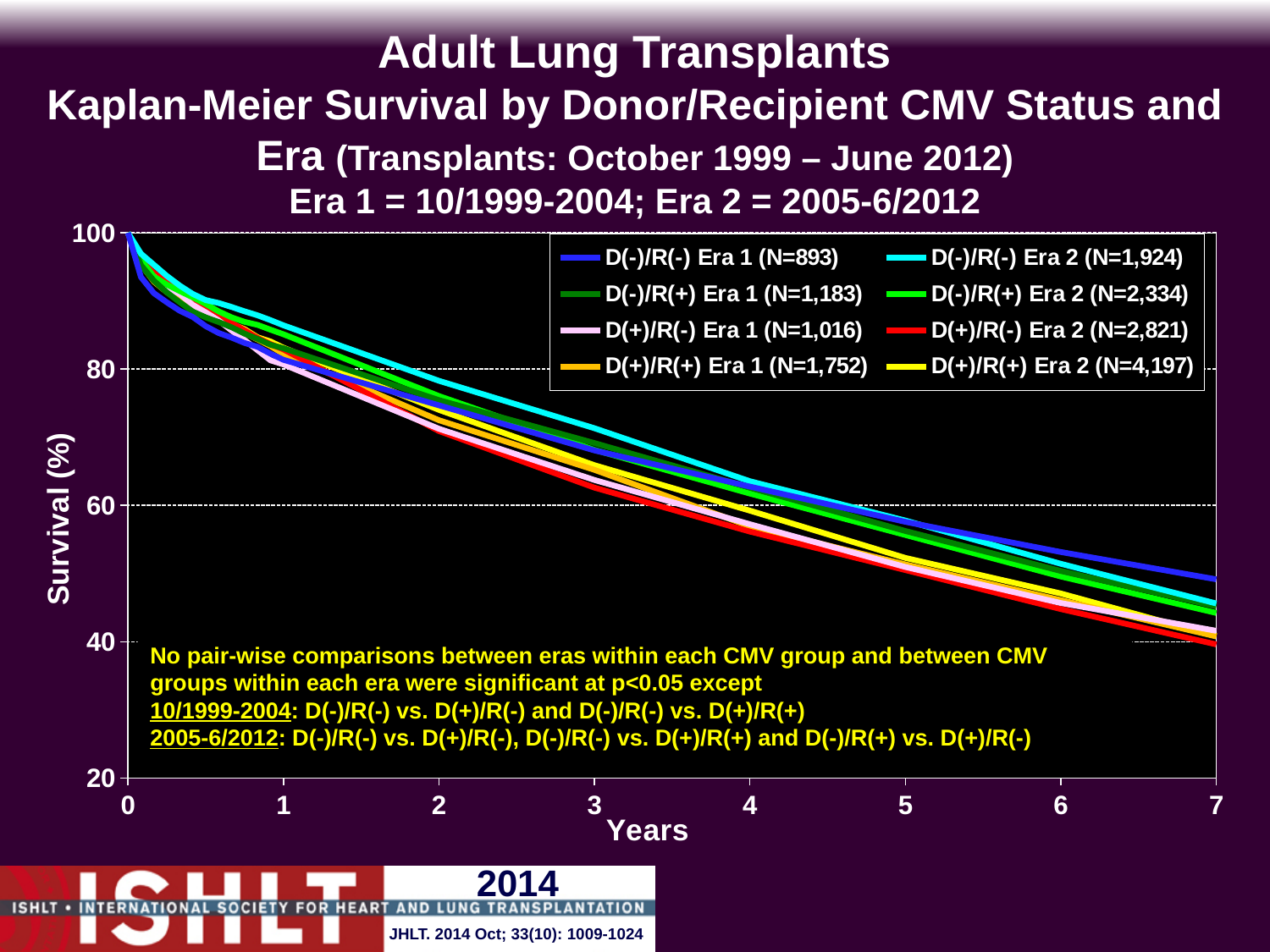
Is the survival value for D(-)/R(-) Era 1 at 7 years greater or less than 40? greater Is the survival value for D(-)/R(-) Era 2 at 2 years greater or less than 80? less How many series does the legend list? 8 Which series has the highest survival at 7 years? D(-)/R(-) Era 1 Is the survival value for D(+)/R(-) Era 2 at 5 years greater or less than 60? less At 7 years, which is higher: the survival curve for D(-)/R(-) Era 1 or for D(+)/R(-) Era 2? D(-)/R(-) Era 1 What is the N shown in the legend for D(+)/R(+) Era 2? N=4,197 Do the survival curves rise or fall as years increase? fall What kind of chart is shown on the slide? line chart What is the label of the y axis? Survival (%)